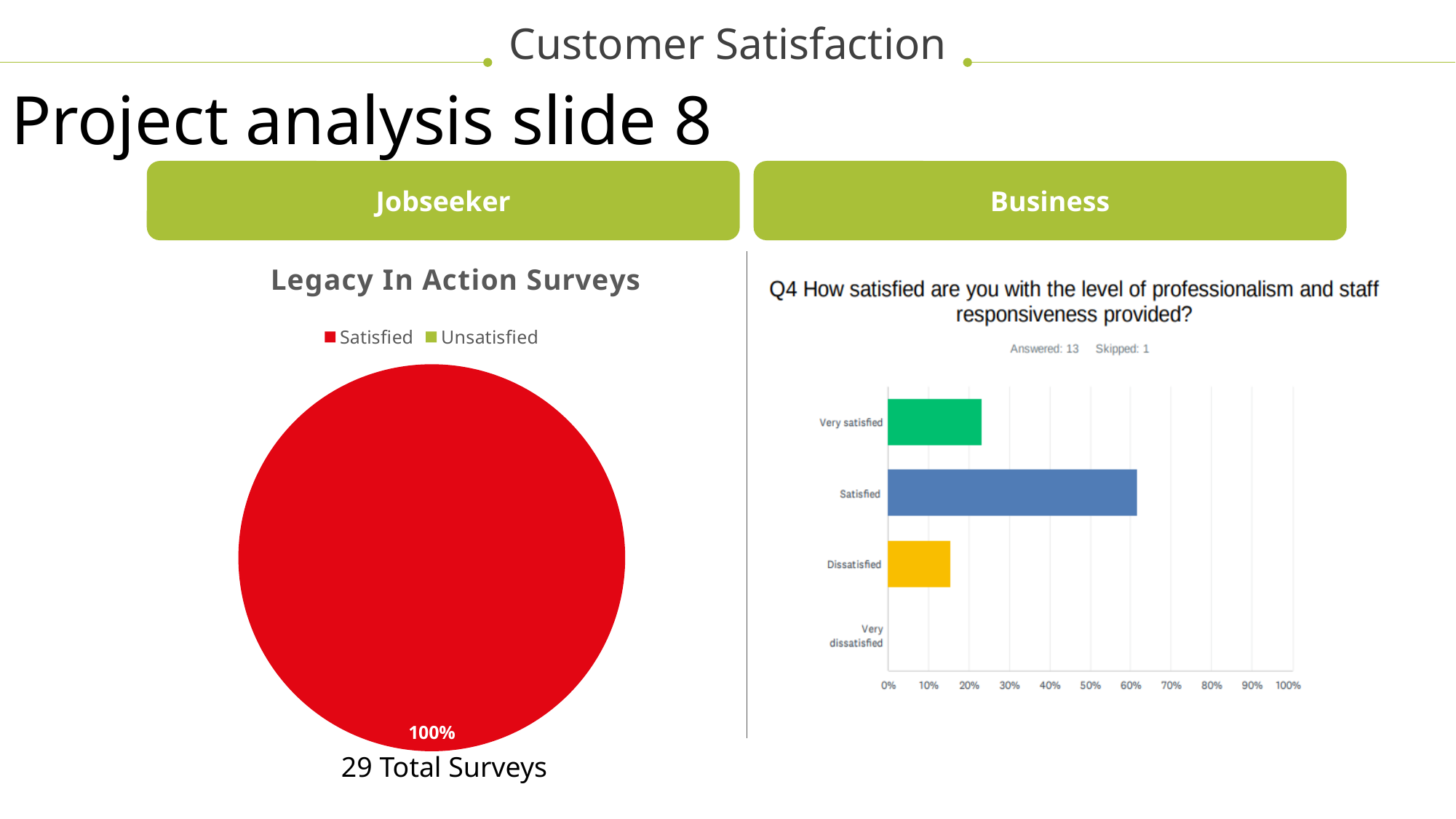
How many total surveys are noted under the Legacy In Action Surveys chart? 29 Total Surveys In the Q4 bar chart on the right, which category has the lowest value? Very dissatisfied In the Legacy In Action Surveys pie chart, what share of the pie is Satisfied? 100% How many series does the legend of the Legacy In Action Surveys chart list? 2 How many categories are shown in the Q4 bar chart on the right? 4 In the Legacy In Action Surveys chart, what colour represents Satisfied? red In the Q4 bar chart on the right, which is larger, Very satisfied or Dissatisfied? Very satisfied In the Q4 bar chart on the right, is the value for Dissatisfied greater or less than 20%? less What kind of chart is the Q4 chart on the right? bar chart What kind of chart is the Legacy In Action Surveys chart on the left? pie chart In the Q4 bar chart on the right, which category has the highest value? Satisfied In the Q4 bar chart on the right, is the value for Satisfied greater or less than 50%? greater